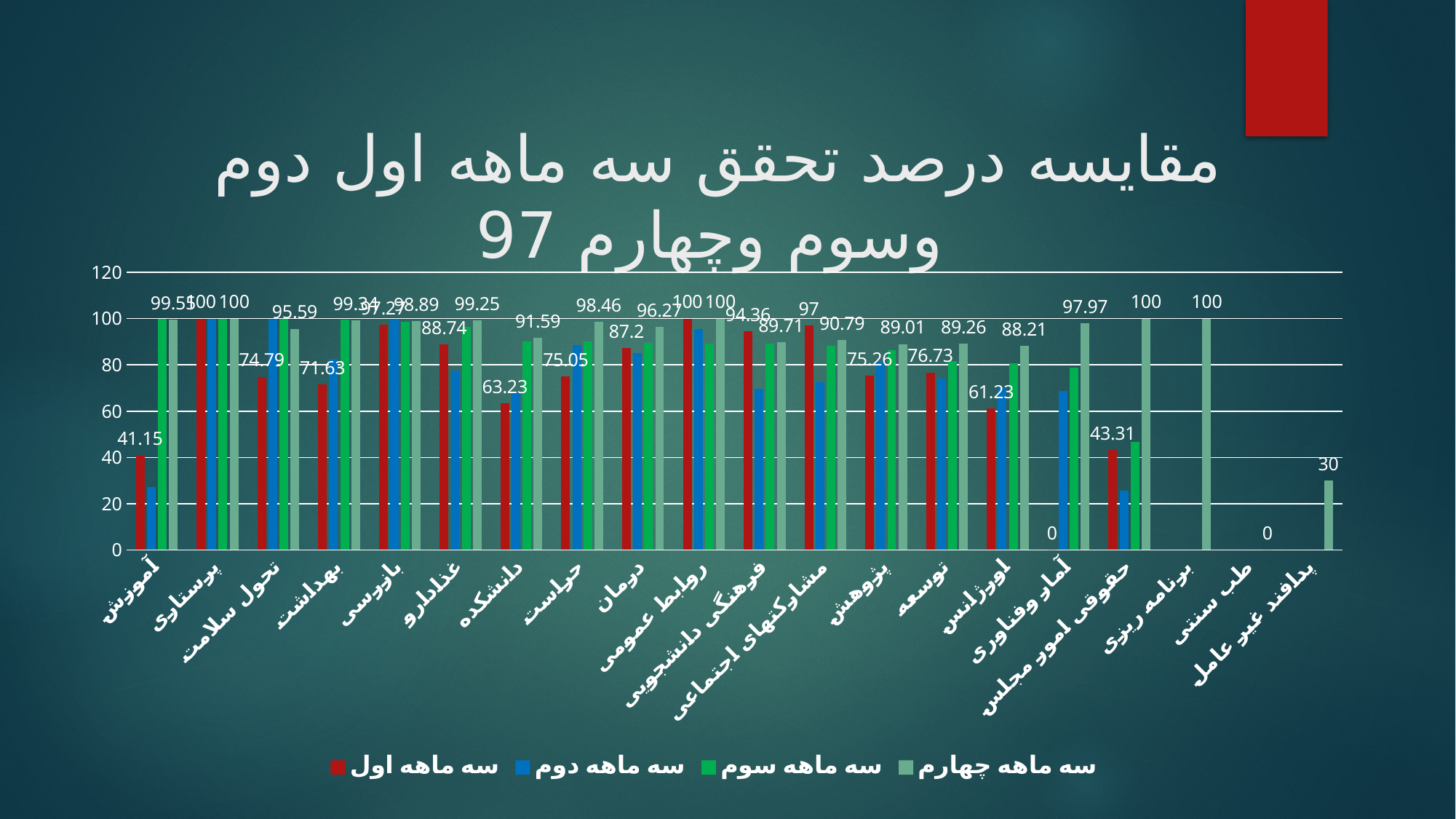
What is the value of سه ماهه چهارم for آموزش? 99.55 What is the value of سه ماهه چهارم for پدافند غیر عامل? 30 What is the value of سه ماهه اول for آموزش? 41.15 How many categories are shown along the x axis? 20 How many series does the legend list? 4 Is the value of سه ماهه دوم for آموزش greater or less than 40? less What is the value of سه ماهه اول for دانشکده? 63.23 What kind of chart is shown on the slide? bar chart Which category has the lowest value for سه ماهه چهارم? طب سنتی For فرهنگی دانشجویی, which is larger: سه ماهه اول or سه ماهه چهارم? سه ماهه اول What is the difference between سه ماهه چهارم and سه ماهه اول for آموزش? 58.4 What is the value of سه ماهه اول for اورژانس? 61.23